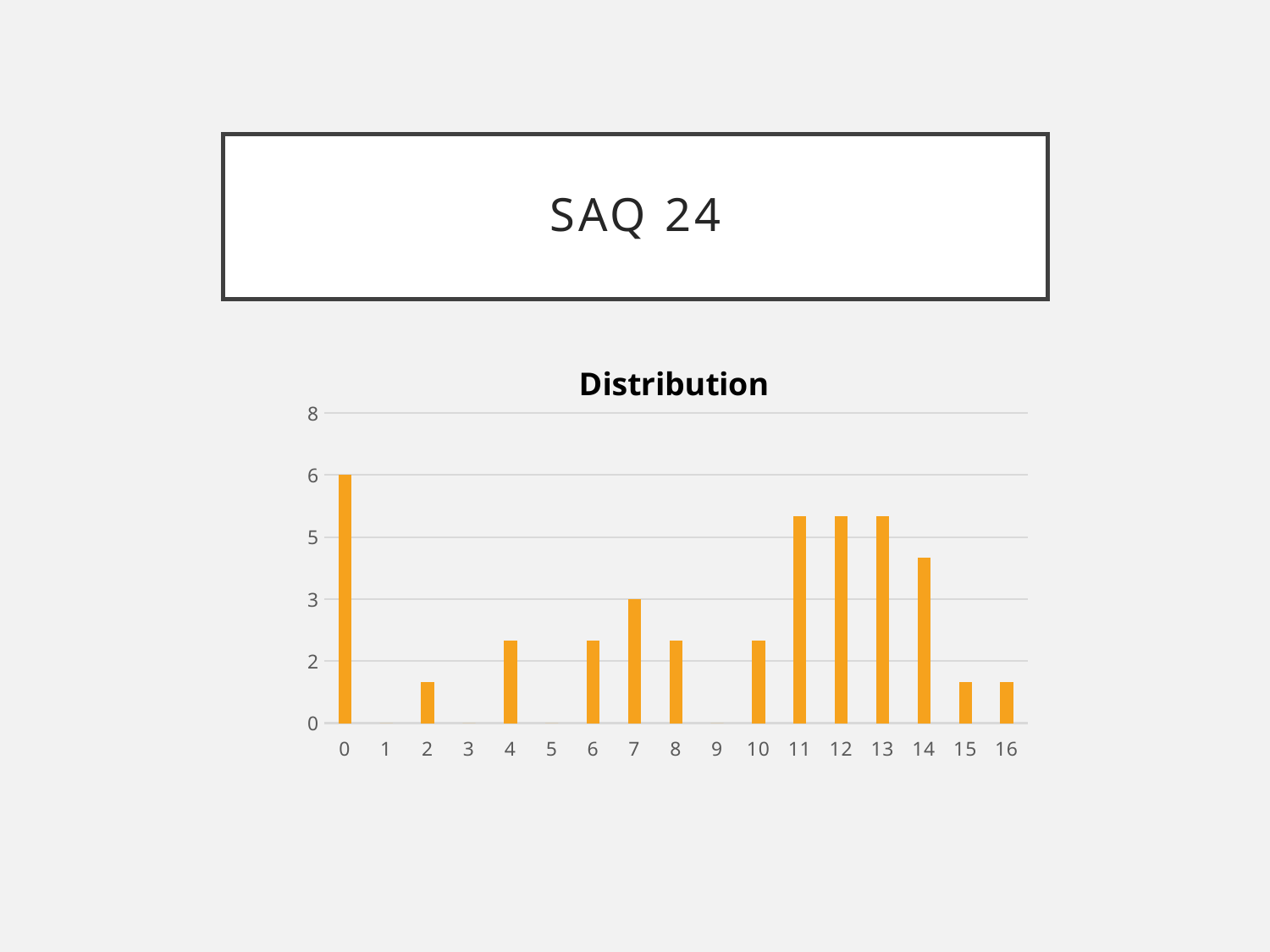
Is the value for category 2 greater or less than 2? less Which has the larger value, category 7 or category 14? 14 What is the title of the chart? Distribution Is the value for category 7 greater or less than 2? greater What colour are the bars in the chart? orange Which has the larger value, category 0 or category 12? 0 Is the value for category 14 greater or less than 5? less Which category has the highest bar in the Distribution chart? 0 How many categories are labelled on the x axis of the chart? 17 What kind of chart is shown on the slide? bar chart How many categories on the x axis have a visible bar? 13